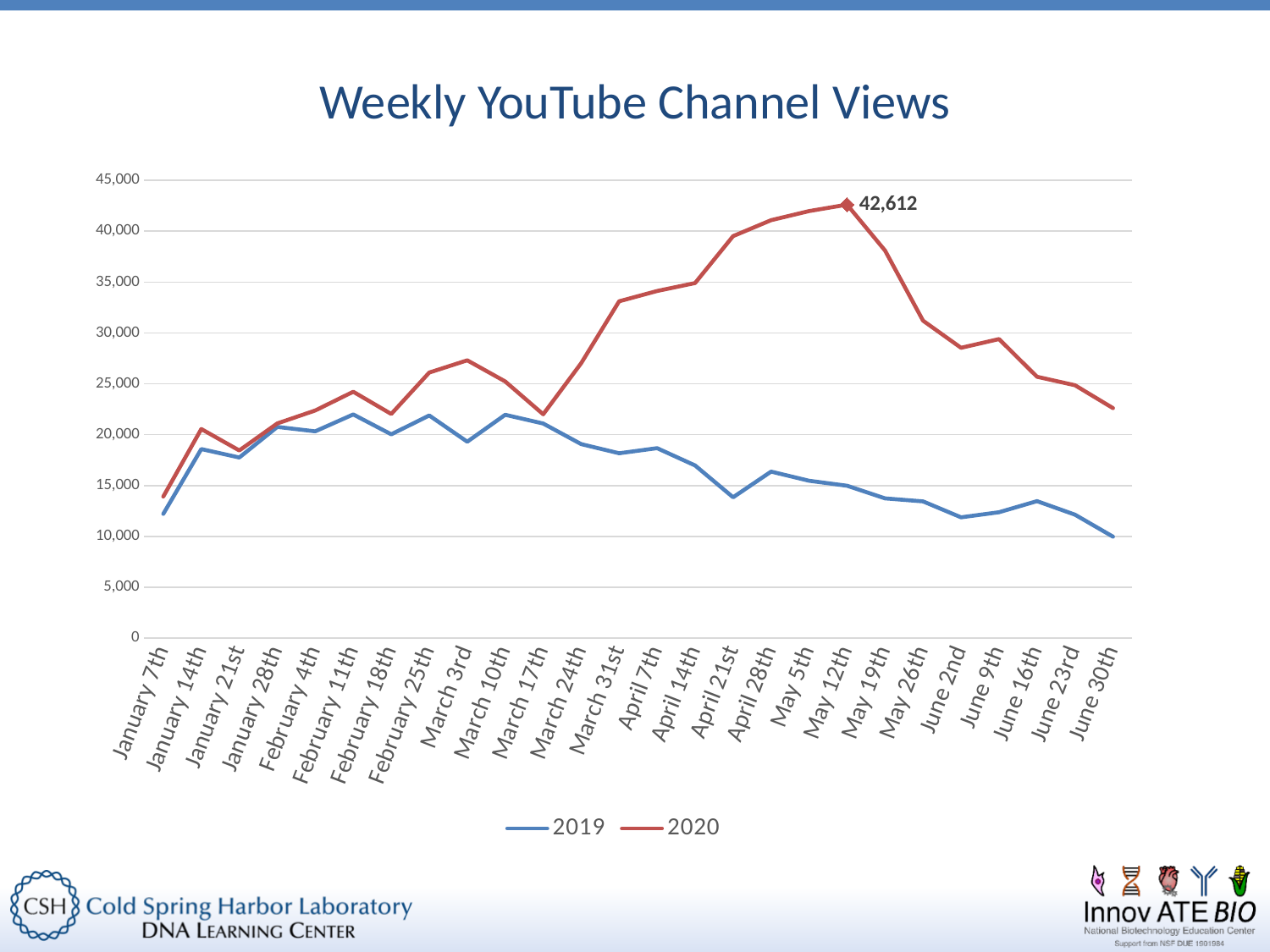
Does the 2019 series rise or fall from April 7th to June 30th? fall In which week does the 2020 series reach its highest value? May 12th Does the 2020 series rise or fall from March 17th to May 12th? rise How many weekly points are plotted along the x axis? 26 In which week does the 2019 series reach its lowest value? June 30th At January 7th, which series has the larger value, 2019 or 2020? 2020 At May 12th, which series has the larger value, 2019 or 2020? 2020 Is the 2020 value for March 31st greater or less than 30,000? greater Is the 2019 value for June 30th greater or less than 15,000? less What kind of chart is shown on the slide? line chart How many series does the legend list? 2 What is the labelled value for the 2020 series at May 12th? 42,612